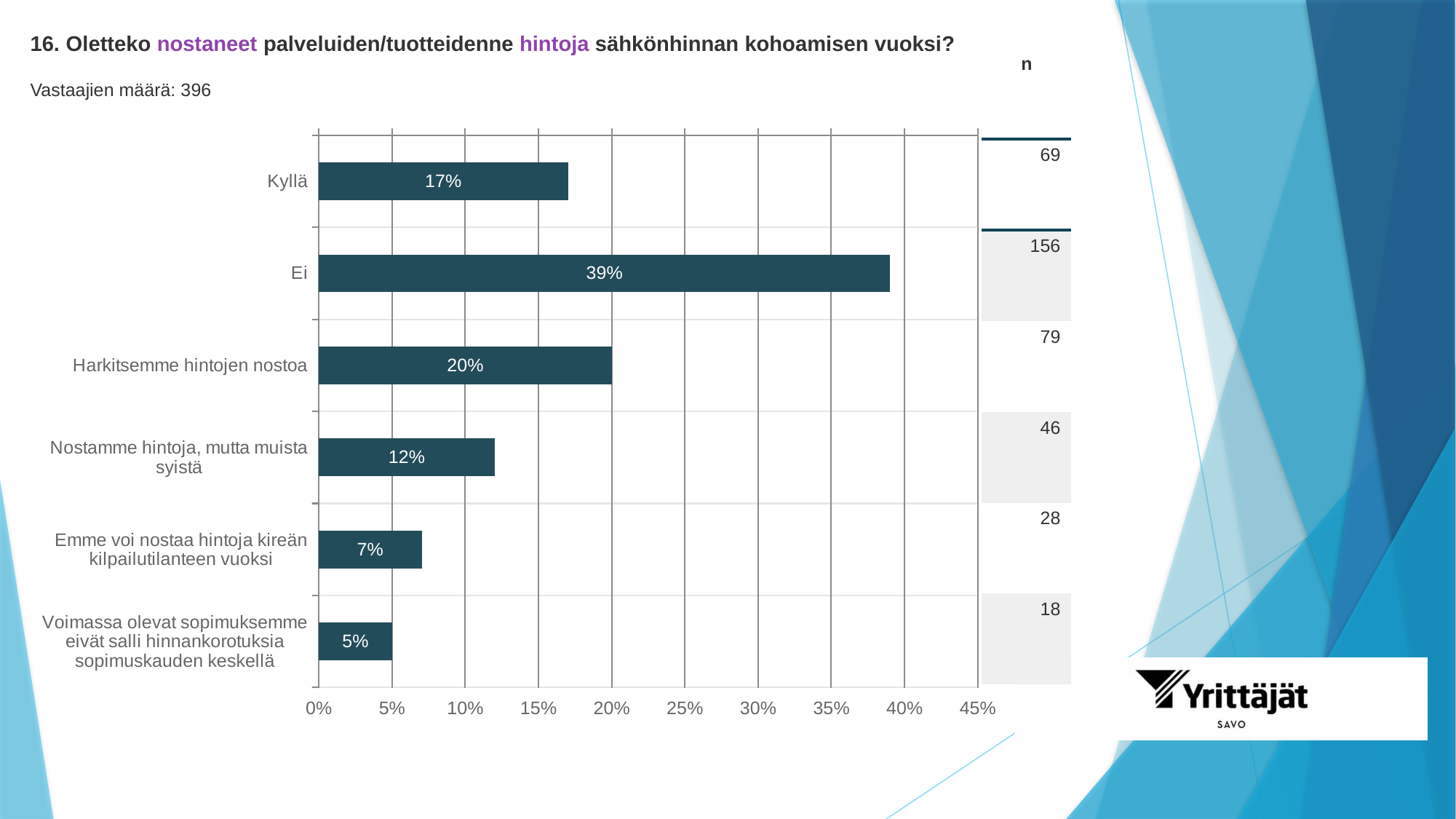
How many categories are shown in the chart? 6 Which category has the highest percentage? Ei What is the difference in percentage points between "Ei" and "Kyllä"? 22 What percentage is shown for "Ei"? 39% Which has a higher percentage, "Harkitsemme hintojen nostoa" or "Nostamme hintoja, mutta muista syistä"? Harkitsemme hintojen nostoa Which category has the lowest percentage? Voimassa olevat sopimuksemme eivät salli hinnankorotuksia sopimuskauden keskellä What is the total number of respondents (Vastaajien määrä) stated on the slide? 396 What kind of chart is shown on the slide? Bar chart What is the n value shown for "Nostamme hintoja, mutta muista syistä"? 46 What percentage is shown for "Harkitsemme hintojen nostoa"? 20% What percentage is shown for "Kyllä"? 17% What is the n value shown for "Emme voi nostaa hintoja kireän kilpailutilanteen vuoksi"? 28